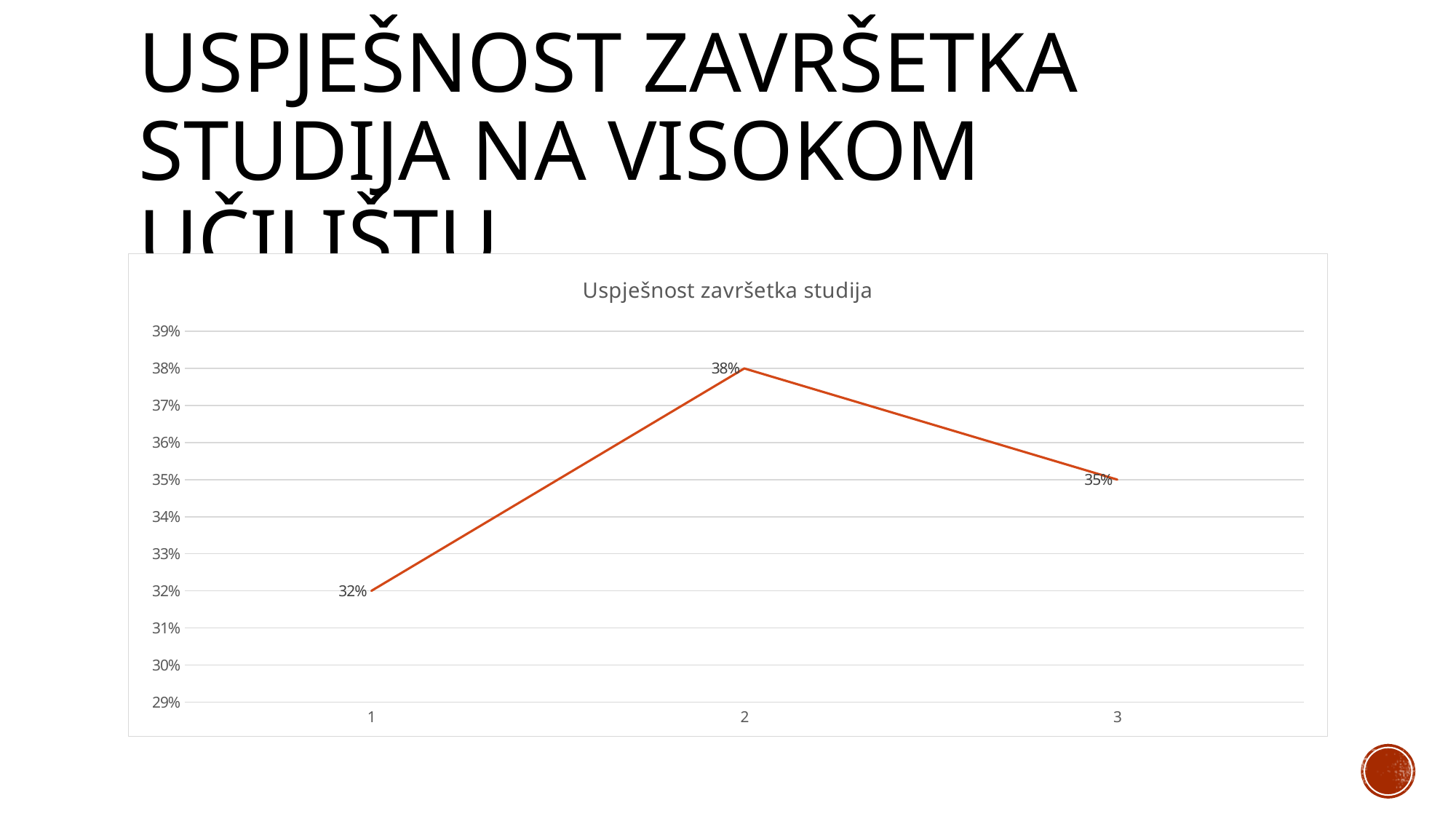
What is the difference between the values for category 2 and category 3? 3% Which category has the lowest value? 1 What is the value for category 2? 38% How many data points are plotted on the chart? 3 What is the difference between the values for category 2 and category 1? 6% Which is larger, the value for category 3 or the value for category 1? category 3 Which category has the highest value? 2 Is the value for category 2 greater or less than 36%? greater What is the title of the chart? Uspješnost završetka studija What kind of chart is shown on the slide? line chart What is the value for category 3? 35% What is the value for category 1? 32%